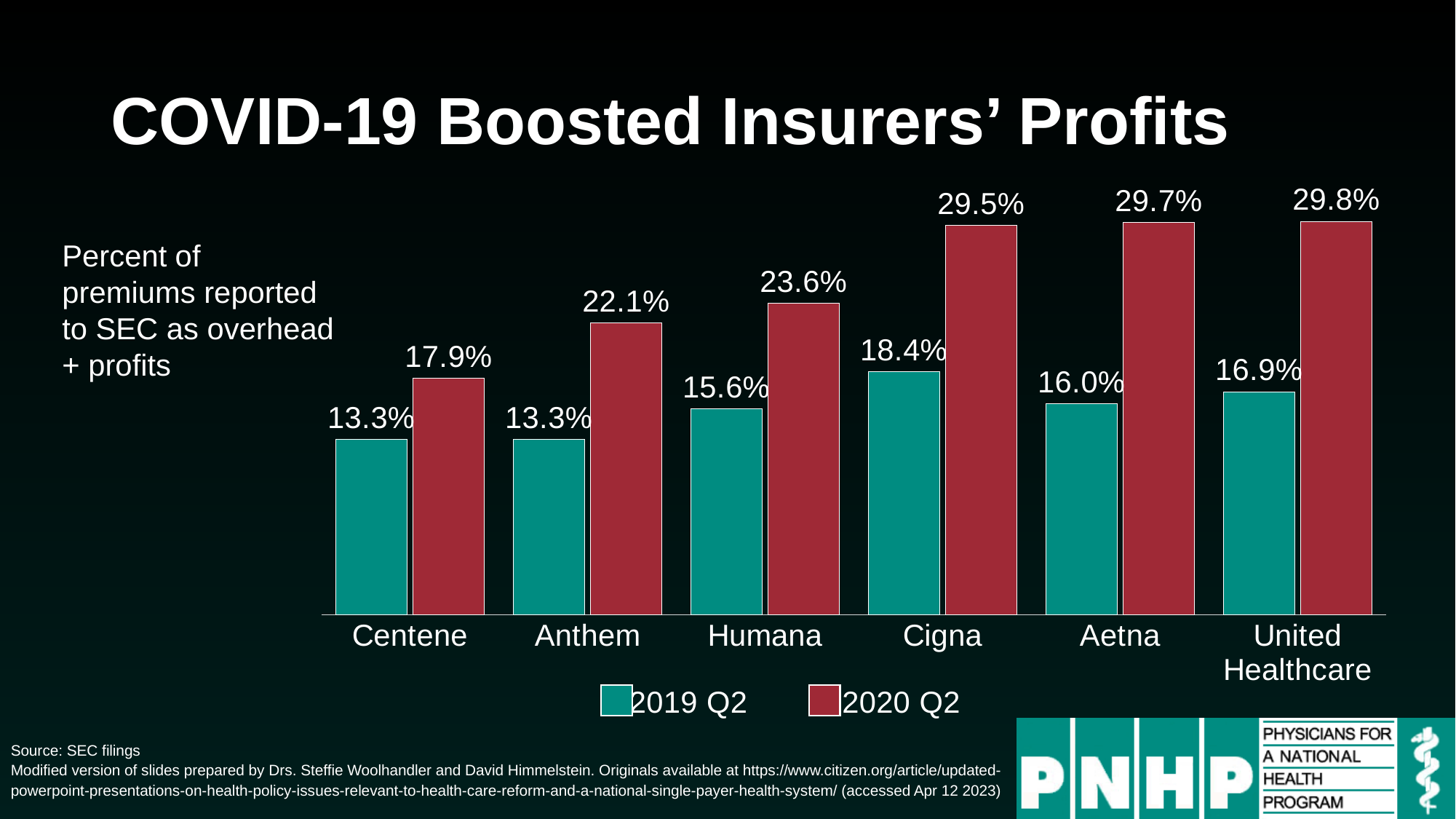
What is the difference between Anthem's 2020 Q2 and 2019 Q2 values? 8.8% Which insurer had the lowest value in 2020 Q2? Centene Which insurer had the highest value in 2019 Q2? Cigna How many insurers are shown on the x axis? 6 What was Aetna's value for 2019 Q2? 16.0% How many series does the legend list? 2 What was Humana's value for 2020 Q2? 23.6% Which insurer had the highest value in 2020 Q2? United Healthcare What is the difference between Aetna's 2020 Q2 and 2019 Q2 values? 13.7% Which is larger: Humana's 2019 Q2 value or United Healthcare's 2019 Q2 value? United Healthcare's 2019 Q2 value What was Cigna's value for 2019 Q2? 18.4% What kind of chart is shown on the slide? Bar chart